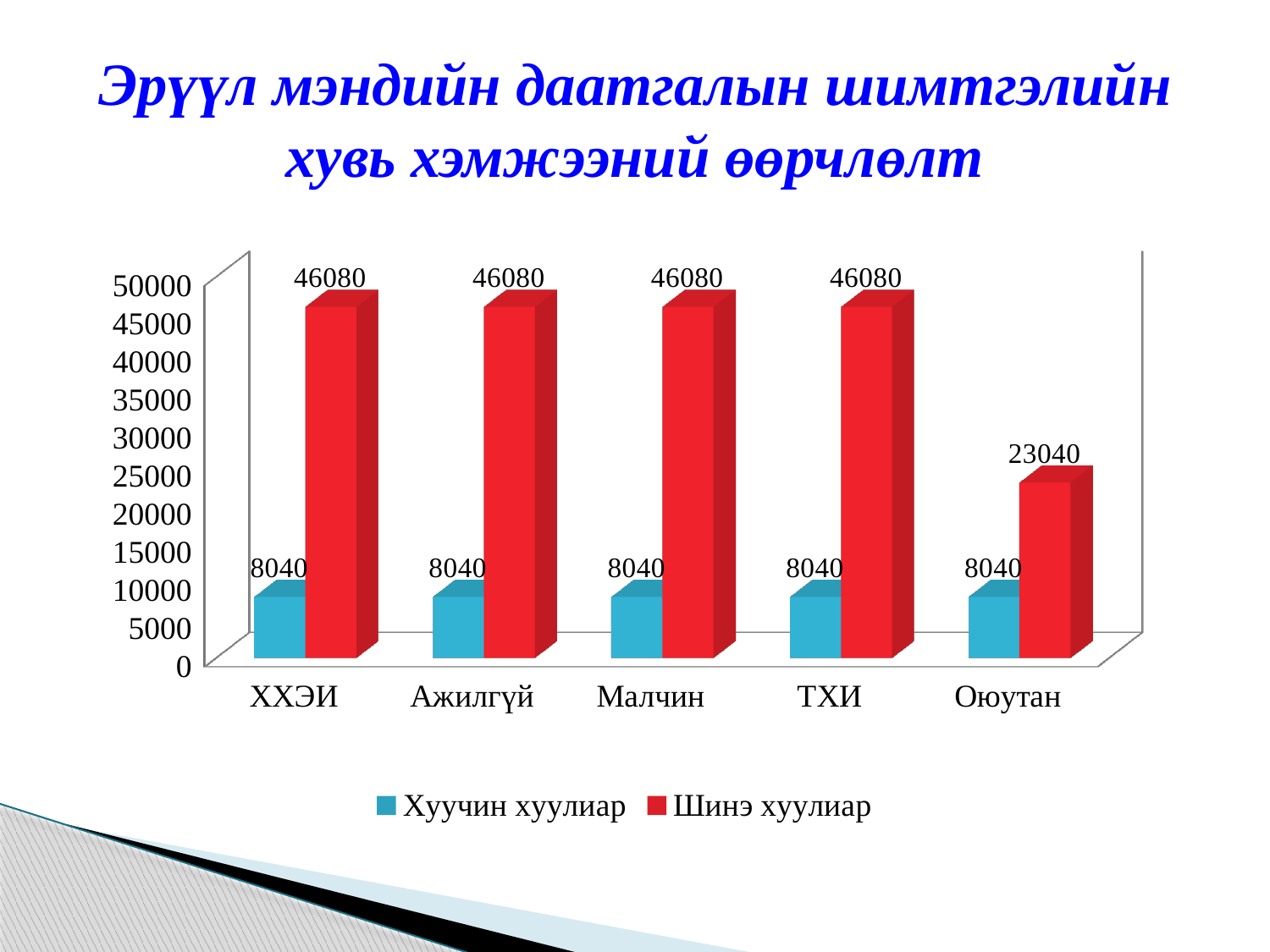
How many series does the legend list? 2 What is the difference between the Шинэ хуулиар and Хуучин хуулиар values for Оюутан? 15000 For Ажилгүй, which series has the larger value, Хуучин хуулиар or Шинэ хуулиар? Шинэ хуулиар What kind of chart is shown on the slide? bar chart What is the value for ХХЭИ in the Хуучин хуулиар series? 8040 What is the value for Оюутан in the Шинэ хуулиар series? 23040 What is the difference between the Шинэ хуулиар and Хуучин хуулиар values for ТХИ? 38040 Which colour represents the Шинэ хуулиар series? red How many categories are shown on the x axis? 5 What is the value for Малчин in the Шинэ хуулиар series? 46080 Is the Шинэ хуулиар value for Оюутан greater or less than 25000? less Which category has the lowest value in the Шинэ хуулиар series? Оюутан